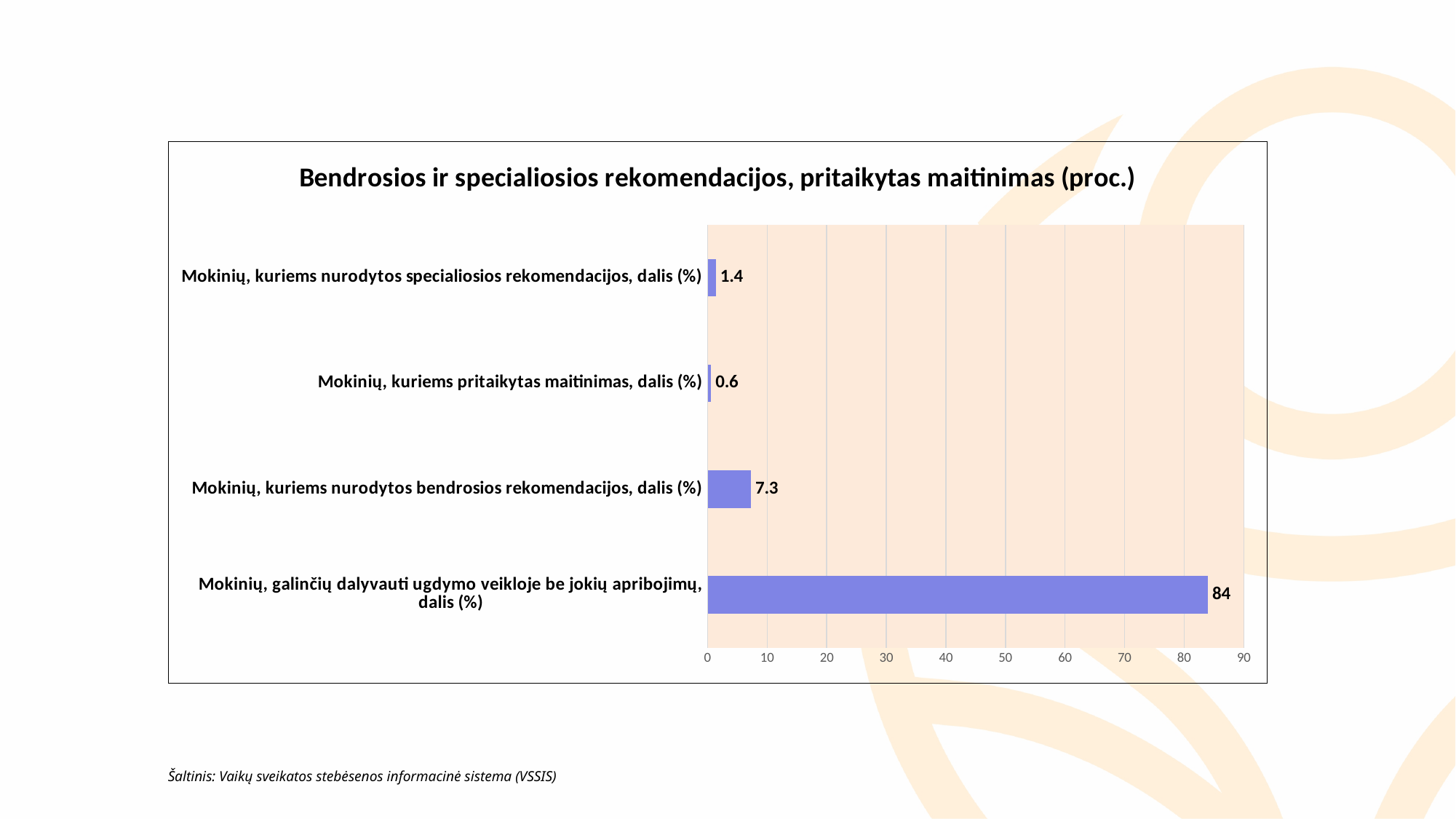
Which category has the highest value? Mokinių, galinčių dalyvauti ugdymo veikloje be jokių apribojimų, dalis (%) What is the value for 'Mokinių, kuriems nurodytos specialiosios rekomendacijos, dalis (%)'? 1.4 Which category has the lowest value? Mokinių, kuriems pritaikytas maitinimas, dalis (%) What is the value for 'Mokinių, kuriems nurodytos bendrosios rekomendacijos, dalis (%)'? 7.3 What is the value for 'Mokinių, galinčių dalyvauti ugdymo veikloje be jokių apribojimų, dalis (%)'? 84 How many categories are shown in the chart? 4 Which is larger: the value for 'Mokinių, kuriems nurodytos specialiosios rekomendacijos, dalis (%)' or 'Mokinių, kuriems pritaikytas maitinimas, dalis (%)'? Mokinių, kuriems nurodytos specialiosios rekomendacijos, dalis (%) What kind of chart is shown on the slide? bar chart What is the value for 'Mokinių, kuriems pritaikytas maitinimas, dalis (%)'? 0.6 What is the title of the chart? Bendrosios ir specialiosios rekomendacijos, pritaikytas maitinimas (proc.) What is the difference between the value for 'Mokinių, kuriems nurodytos bendrosios rekomendacijos, dalis (%)' and 'Mokinių, kuriems nurodytos specialiosios rekomendacijos, dalis (%)'? 5.9 Is the value for 'Mokinių, galinčių dalyvauti ugdymo veikloje be jokių apribojimų, dalis (%)' greater or less than 80? greater